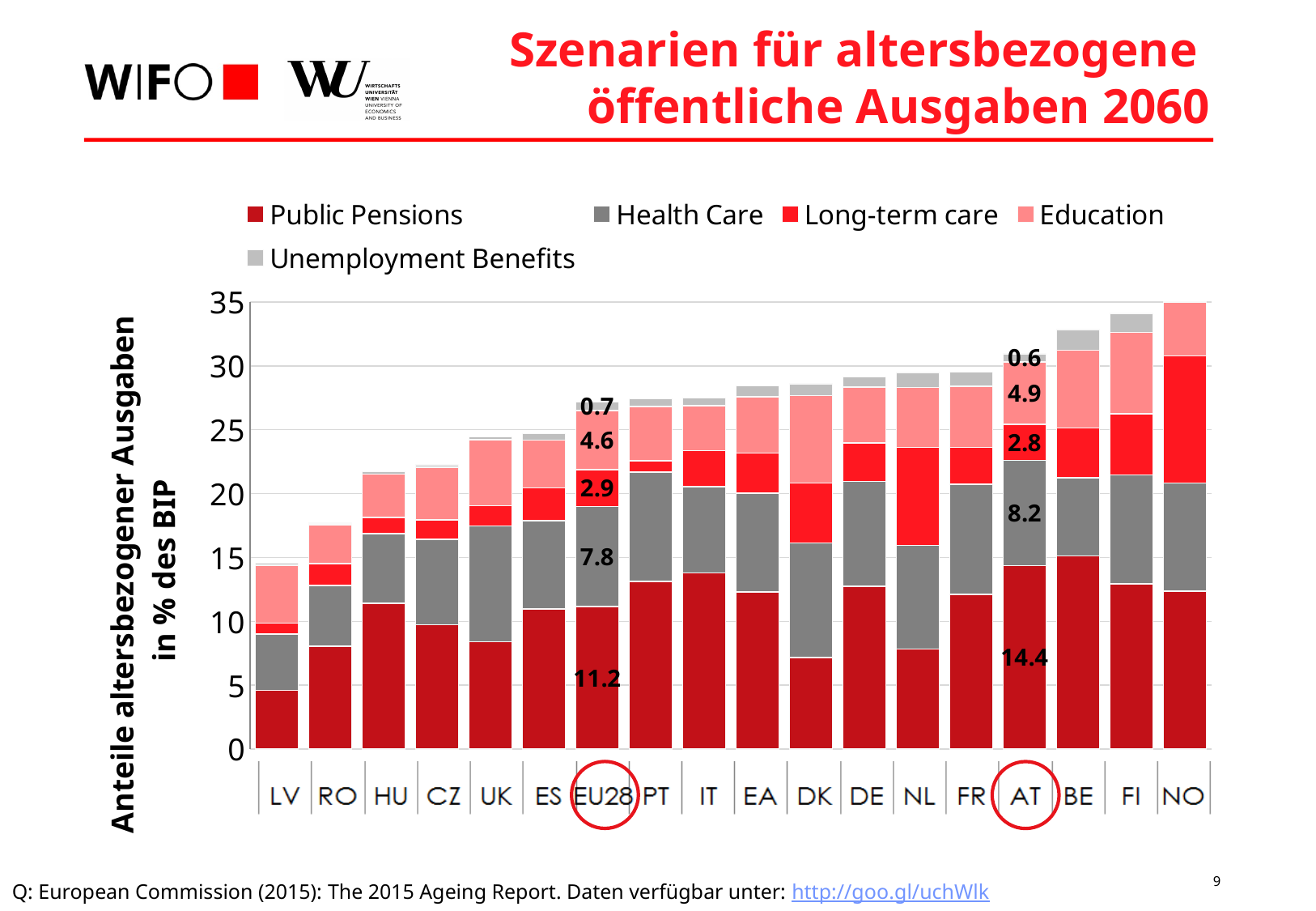
Do the total bar heights rise or fall from left to right along the x axis? rise Which country has the highest total age-related expenditure? NO What is the Education value for EU28? 4.6 What is the Long-term care value for AT? 2.8 What is the Public Pensions value for EU28? 11.2 What is the Health Care value for AT? 8.2 How many countries or regions are shown on the x axis? 18 What is the total of the stacked bar for AT? 30.9 How many series does the legend list? 5 Is the total value for NO greater or less than 30? greater How much larger is the Public Pensions value for AT than for EU28? 3.2 What is the total of the stacked bar for EU28? 27.2